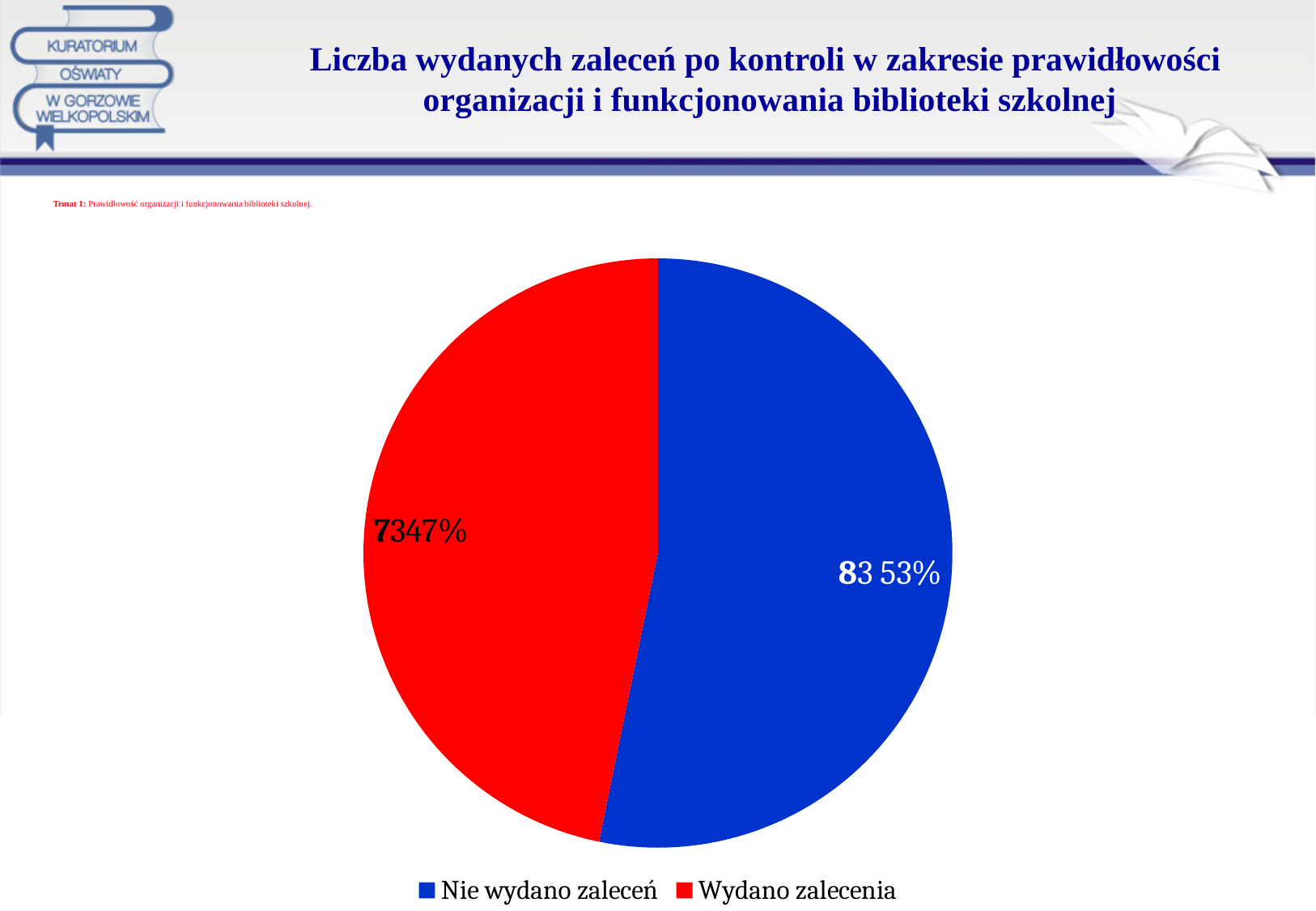
Which is larger, the value for 'Nie wydano zaleceń' or for 'Wydano zalecenia'? Nie wydano zaleceń Which category has the largest slice of the pie? Nie wydano zaleceń What percentage share does the 'Nie wydano zaleceń' slice have? 53% What is the number shown for 'Wydano zalecenia'? 73 Which category has the smallest slice of the pie? Wydano zalecenia How many entries does the legend list? 2 What is the number shown for 'Nie wydano zaleceń'? 83 How many slices does the pie chart have? 2 What is the difference between the number for 'Nie wydano zaleceń' and the number for 'Wydano zalecenia'? 10 What percentage share does the 'Wydano zalecenia' slice have? 47% What kind of chart is shown on the slide? pie chart What colour is the 'Wydano zalecenia' slice? red